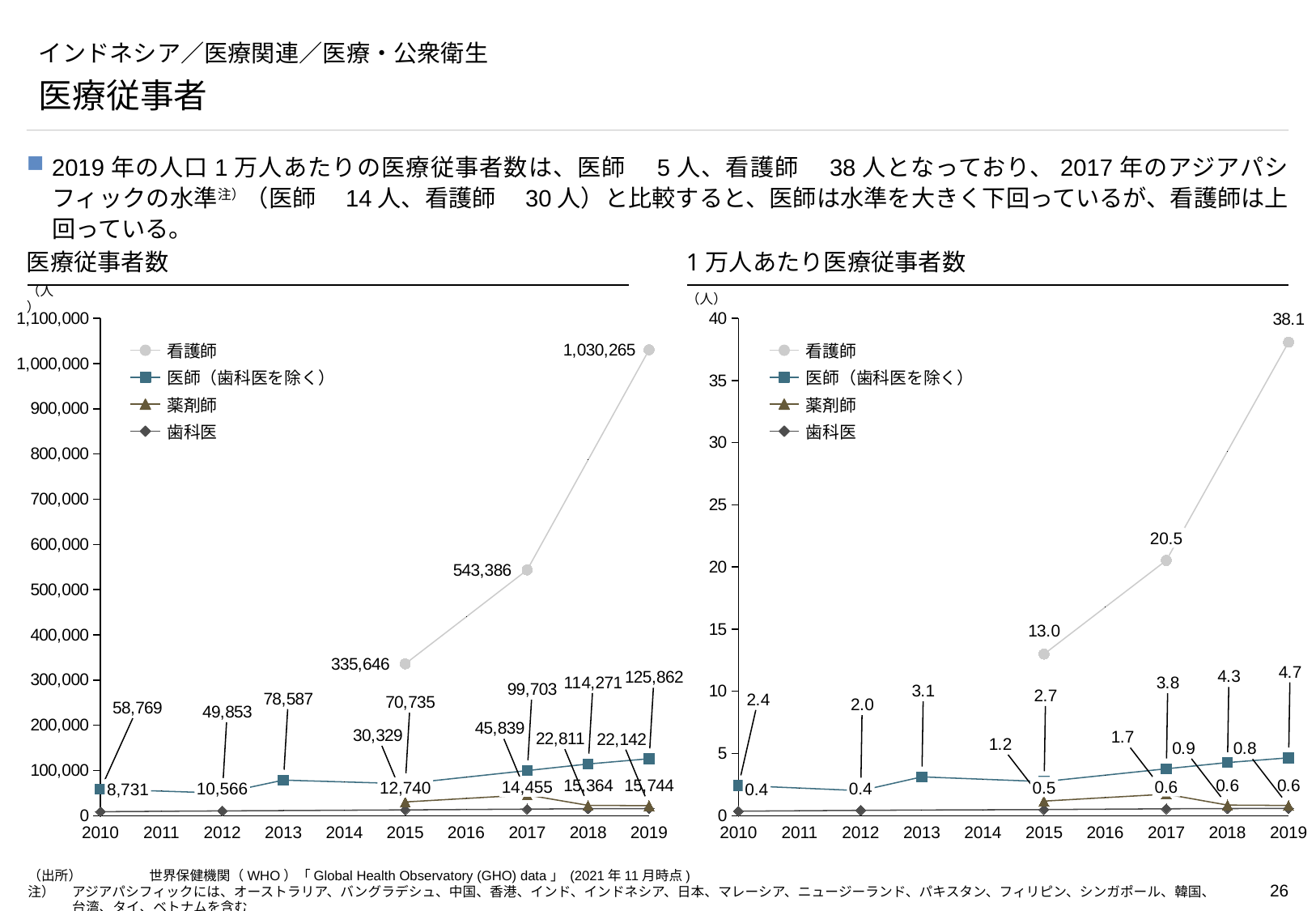
In the left chart titled 医療従事者数, what is the difference between the 医師（歯科医を除く） values in 2019 and 2018? 11,591 In the right chart titled 1万人あたり医療従事者数, what is the value for 看護師 in 2017? 20.5 In the right chart titled 1万人あたり医療従事者数, what is the value for 薬剤師 in 2018? 0.9 In the left chart titled 医療従事者数, what is the value for 看護師 in 2019? 1,030,265 In the right chart titled 1万人あたり医療従事者数, what is the difference between the 看護師 values in 2019 and 2017? 17.6 In the right chart titled 1万人あたり医療従事者数, is the value for 看護師 in 2015 greater or less than 10? greater In the left chart titled 医療従事者数, what is the value for 医師（歯科医を除く） in 2013? 78,587 What kind of chart is the left chart titled 医療従事者数? Line chart In the left chart titled 医療従事者数, which year has the highest value for 看護師? 2019 How many years are shown on the x axis of the left chart titled 医療従事者数? 10 How many series does the legend of the right chart titled 1万人あたり医療従事者数 list? 4 In the left chart titled 医療従事者数, which is larger in 2017: the value for 薬剤師 or the value for 歯科医? 薬剤師